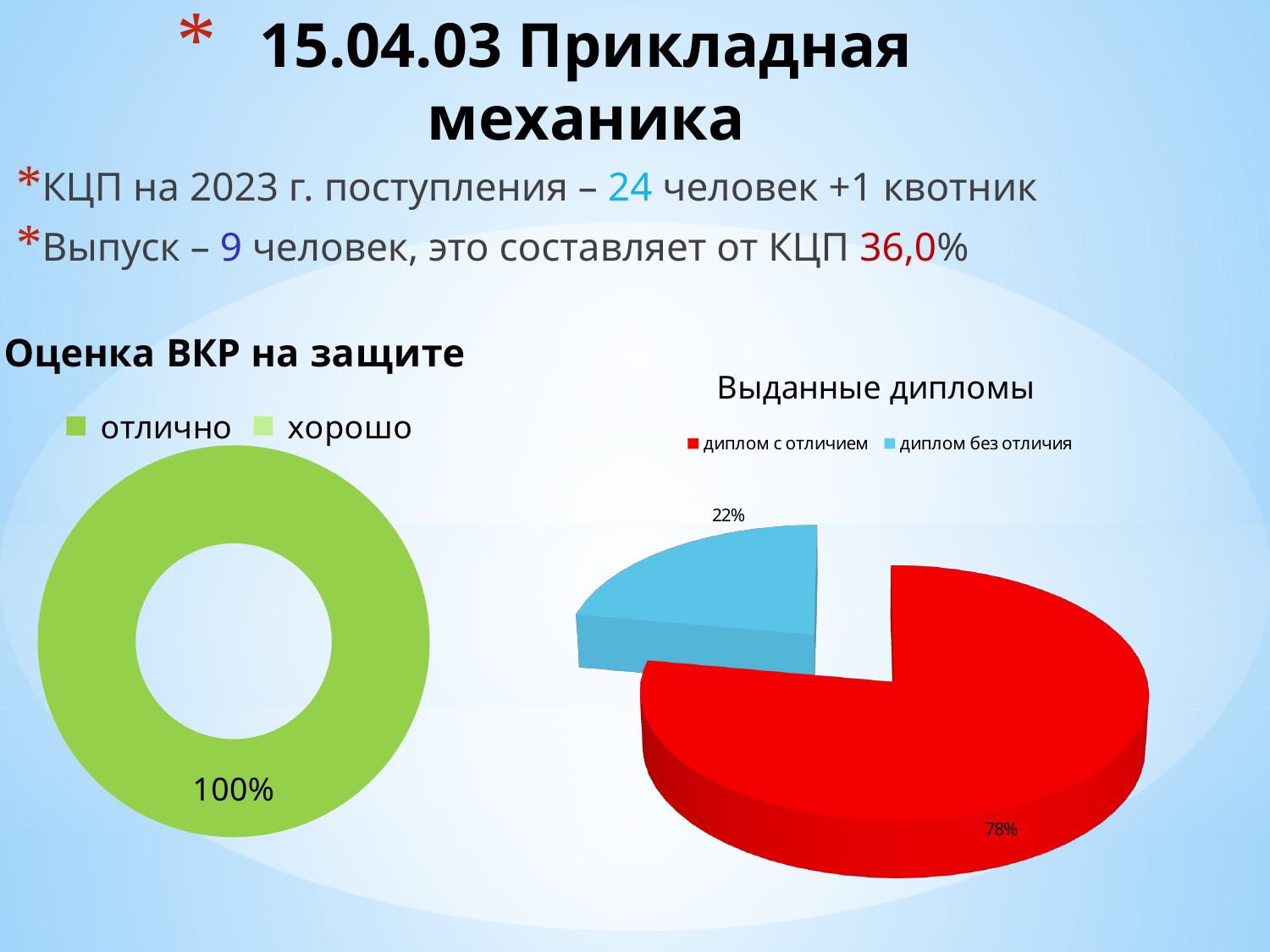
In the 'Выданные дипломы' chart, what colour is the slice for 'диплом без отличия'? light blue In the 'Выданные дипломы' chart, which is larger: 'диплом с отличием' or 'диплом без отличия'? диплом с отличием How many legend entries does the 'Выданные дипломы' chart have? 2 What kind of chart is 'Оценка ВКР на защите'? doughnut chart In the 'Выданные дипломы' chart, which category has the largest slice? диплом с отличием In the 'Выданные дипломы' chart, which category has the smallest slice? диплом без отличия In the 'Выданные дипломы' chart, what percentage is shown for 'диплом без отличия'? 22% How many legend entries does the 'Оценка ВКР на защите' chart have? 2 What kind of chart is 'Выданные дипломы'? pie chart In the 'Оценка ВКР на защите' chart, what percentage is shown on the chart? 100% In the 'Выданные дипломы' chart, what is the difference in percentage points between 'диплом с отличием' and 'диплом без отличия'? 56 In the 'Выданные дипломы' chart, what percentage is shown for 'диплом с отличием'? 78%